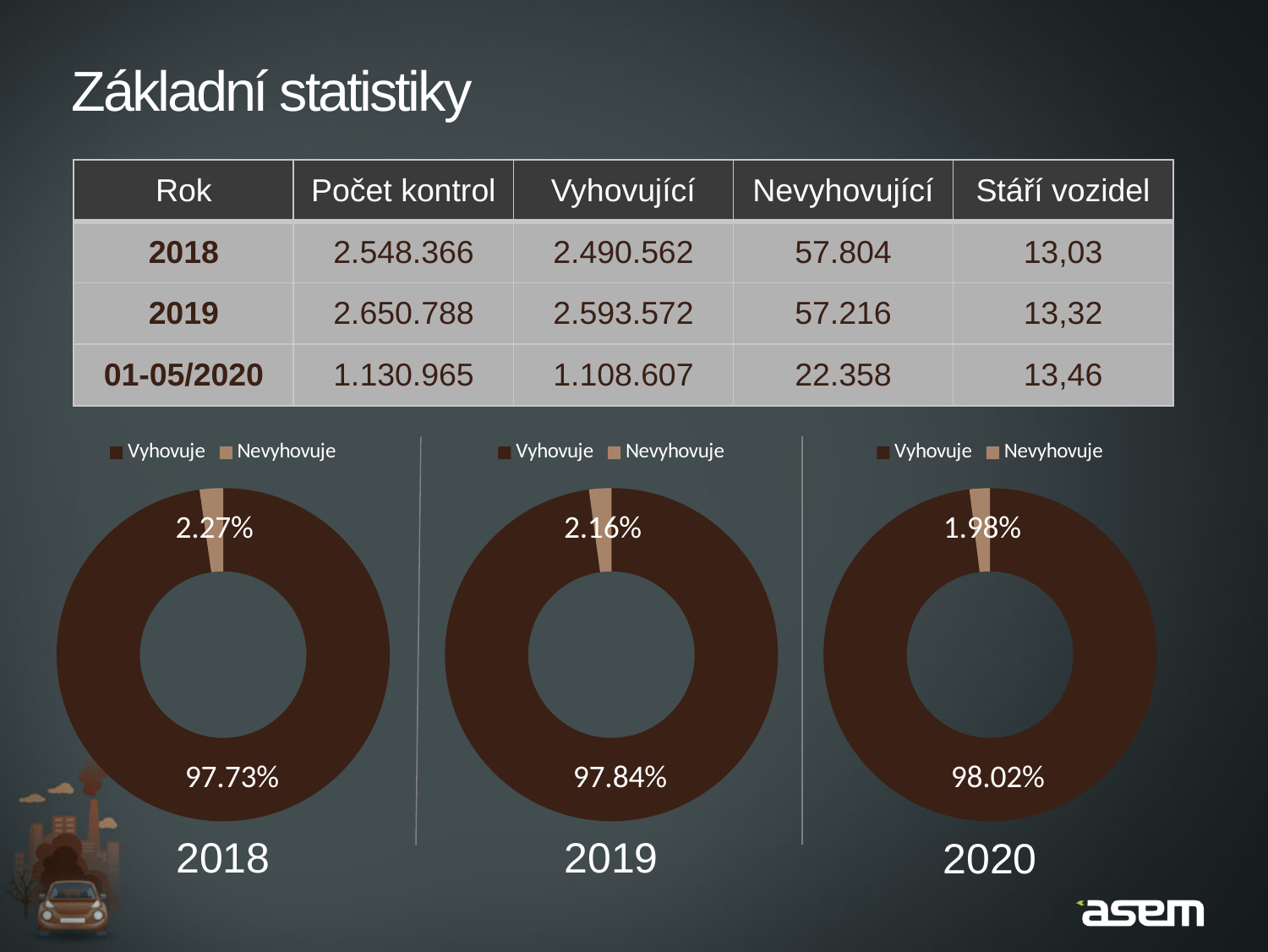
In the 2018 chart, what share is labelled for Nevyhovuje? 2.27% In the 2019 chart, what share is labelled for Vyhovuje? 97.84% In the 2020 chart, what share is labelled for Vyhovuje? 98.02% How many doughnut charts are shown on the slide? 3 In the 2020 chart, which slice is larger, Vyhovuje or Nevyhovuje? Vyhovuje What kind of chart is used for the 2018 chart? doughnut chart Which of the three charts shows the smallest Nevyhovuje share? 2020 In the 2018 chart, what share is labelled for Vyhovuje? 97.73% How many slices does the 2019 chart have? 2 In the 2019 chart, what share is labelled for Nevyhovuje? 2.16% How many entries does the legend of the 2018 chart list? 2 In the 2020 chart, what share is labelled for Nevyhovuje? 1.98%